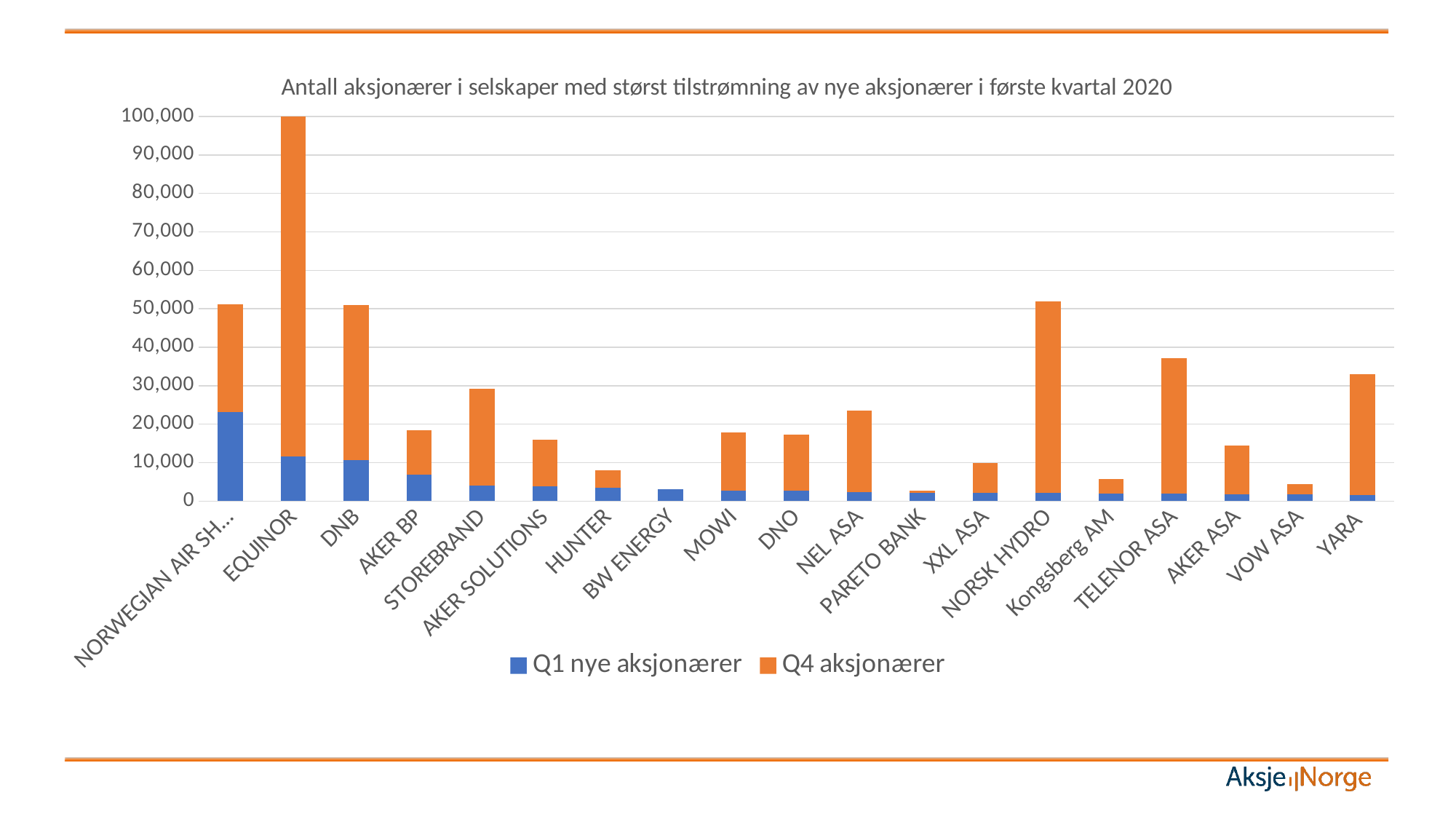
Which company has the largest Q1 nye aksjonærer (blue) segment? NORWEGIAN AIR SH... Is the total bar for HUNTER greater or less than 10,000? less How many companies are shown on the x axis? 19 Which company has the tallest bar overall? EQUINOR Which company has the shortest bar overall? PARETO BANK What kind of chart is shown on the slide? Stacked bar chart Which has the taller bar, YARA or AKER ASA? YARA Is the total bar for NORSK HYDRO greater or less than 40,000? greater What are the two series named in the legend? Q1 nye aksjonærer and Q4 aksjonærer How many series does the legend list? 2 Is the total bar for TELENOR ASA greater or less than 40,000? less Which has the taller bar, NORSK HYDRO or TELENOR ASA? NORSK HYDRO